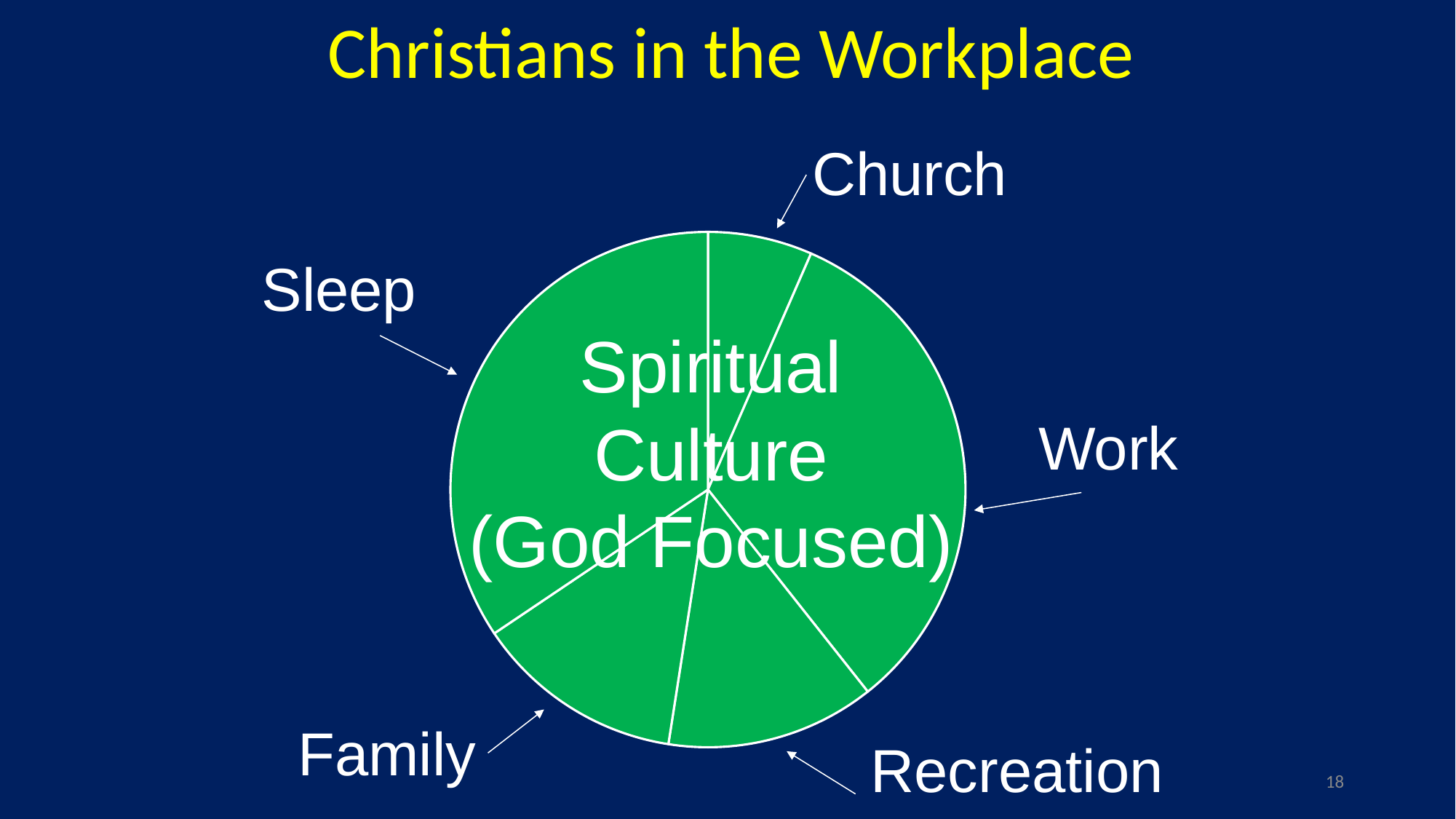
Which slice is larger, Church or Sleep? Sleep Which slice is larger, Family or Sleep? Sleep Which slice is larger, Recreation or Work? Work Which slice of the pie chart is the smallest? Church How many slices does the pie chart have? 5 What text is written in the centre of the pie chart? Spiritual Culture (God Focused) What is the title of the slide containing the pie chart? Christians in the Workplace What kind of chart is shown on the slide? pie chart